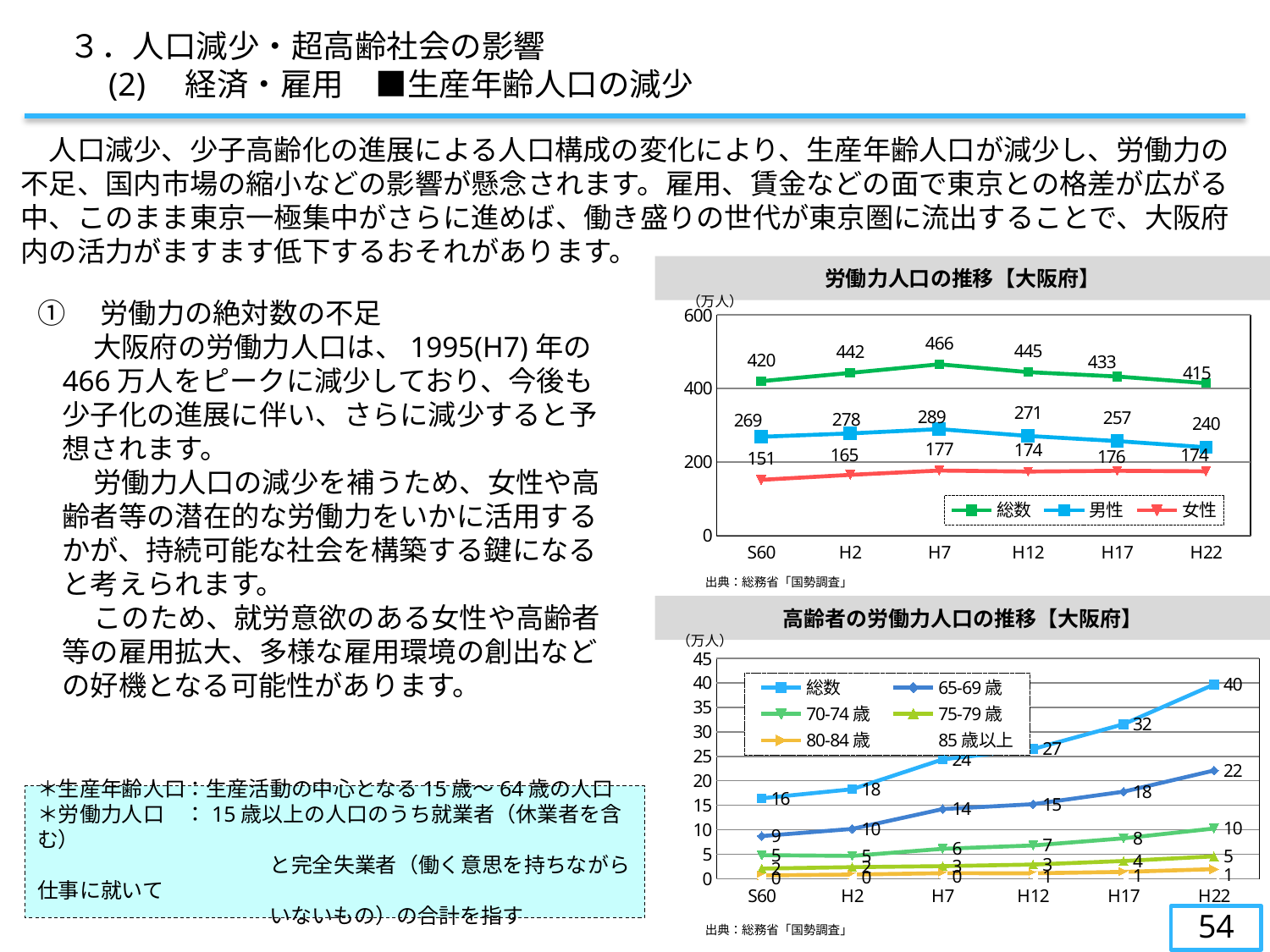
In the chart titled 労働力人口の推移【大阪府】, at which year is 男性 lowest? H22 In the chart titled 労働力人口の推移【大阪府】, what is the difference between 総数 at H7 and 総数 at H22? 51 In the chart titled 高齢者の労働力人口の推移【大阪府】, how many series does the legend list? 6 In the chart titled 労働力人口の推移【大阪府】, what is the value of 男性 at H22? 240 In the chart titled 高齢者の労働力人口の推移【大阪府】, does 総数 rise or fall from S60 to H22? rise In the chart titled 労働力人口の推移【大阪府】, what is the value of 総数 at H7? 466 In the chart titled 労働力人口の推移【大阪府】, what is the value of 女性 at S60? 151 In the chart titled 労働力人口の推移【大阪府】, what kind of chart is it? line chart In the chart titled 高齢者の労働力人口の推移【大阪府】, what is the value of 総数 at H22? 40 In the chart titled 高齢者の労働力人口の推移【大阪府】, which is larger at H17: 65-69歳 or 70-74歳? 65-69歳 In the chart titled 労働力人口の推移【大阪府】, how many series does the legend list? 3 In the chart titled 労働力人口の推移【大阪府】, at which year is 総数 highest? H7